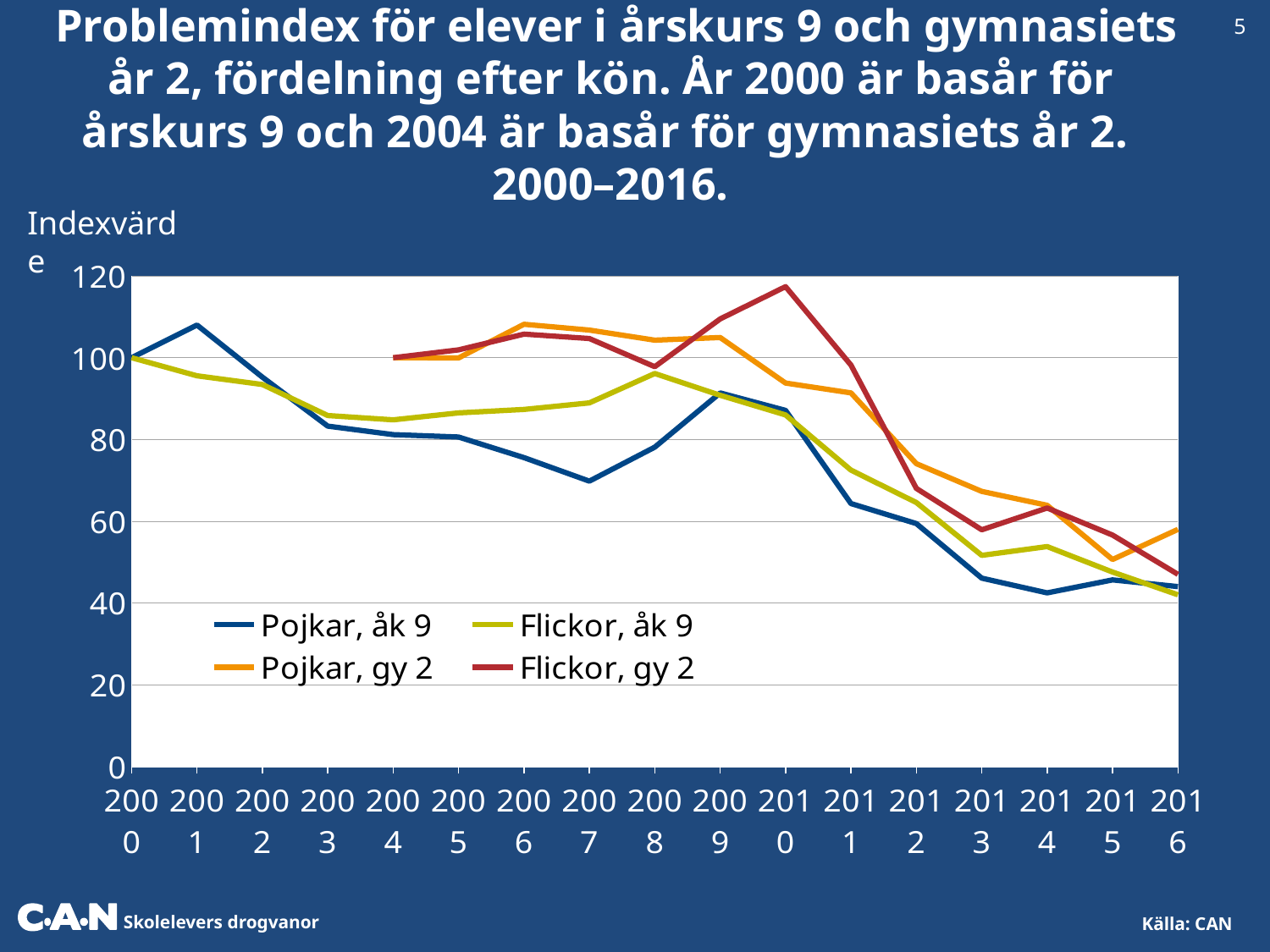
What kind of chart is shown on the slide? line chart In 2016, which is larger: Pojkar, gy 2 or Flickor, åk 9? Pojkar, gy 2 How many series does the legend list? 4 Which series has the lowest value in 2013? Pojkar, åk 9 Is the value for Flickor, gy 2 in 2010 greater or less than 100? greater Which series has the highest value in 2010? Flickor, gy 2 Is the value for Pojkar, åk 9 in 2016 greater or less than 60? less Does the Flickor, åk 9 series rise or fall from 2010 to 2016? fall What is the index value for Pojkar, åk 9 in 2000? 100 Is the value for Pojkar, åk 9 in 2007 greater or less than 80? less How many years are shown along the x axis? 17 What is the index value for Flickor, gy 2 in 2004? 100